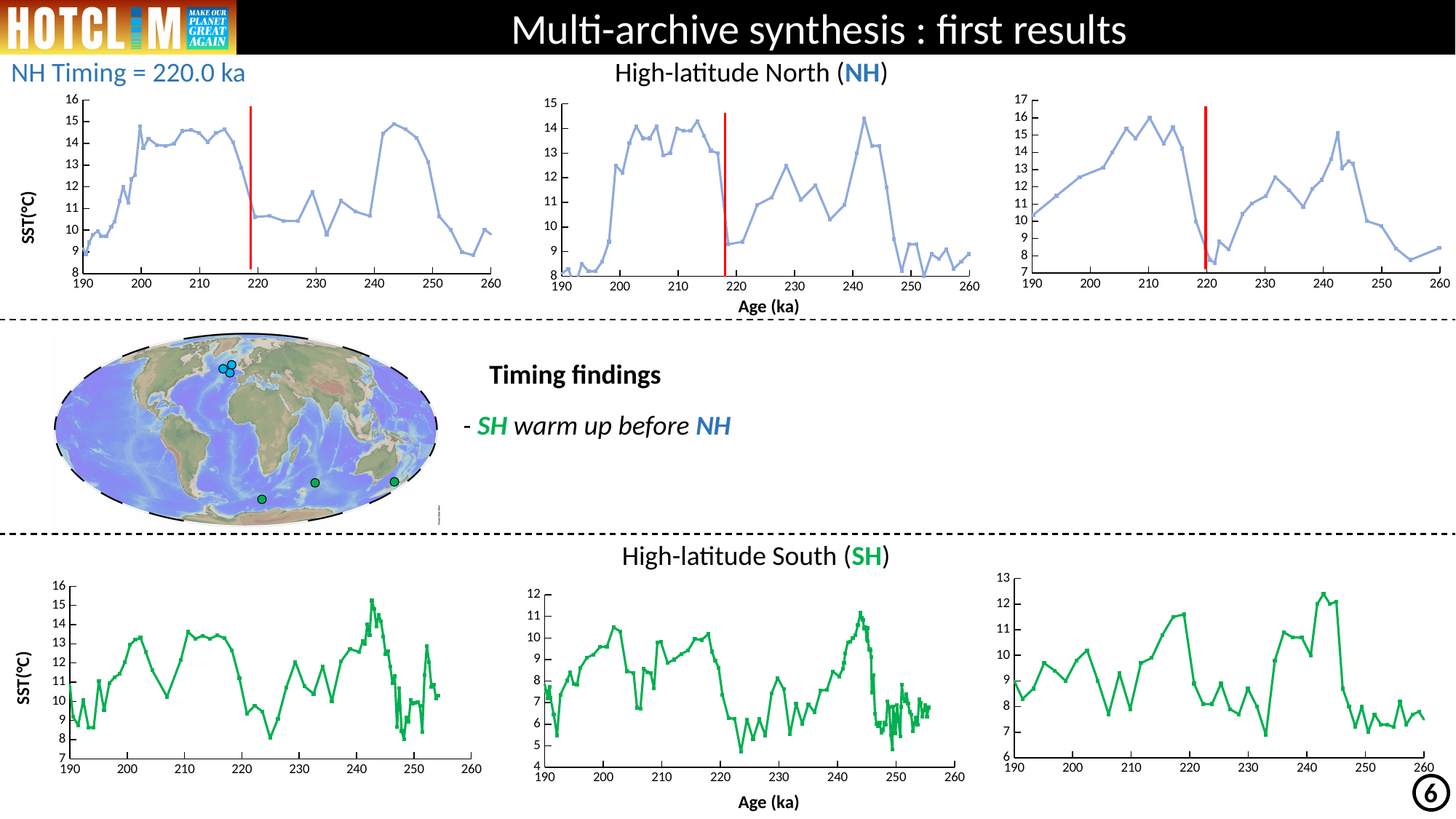
How many line charts are shown on the slide in total? 6 In the top-right NH chart, is the SST value at 210 ka greater or less than 15? greater What kind of chart is the top-left chart under High-latitude North (NH)? line chart What is the x-axis title of the High-latitude North (NH) charts? Age (ka) In the top-left NH chart, is the SST value at 230 ka greater or less than 12? less In the bottom-right SH chart, is the SST value at 233 ka greater or less than 8? less What is the y-axis title of the High-latitude South (SH) charts? SST(°C)